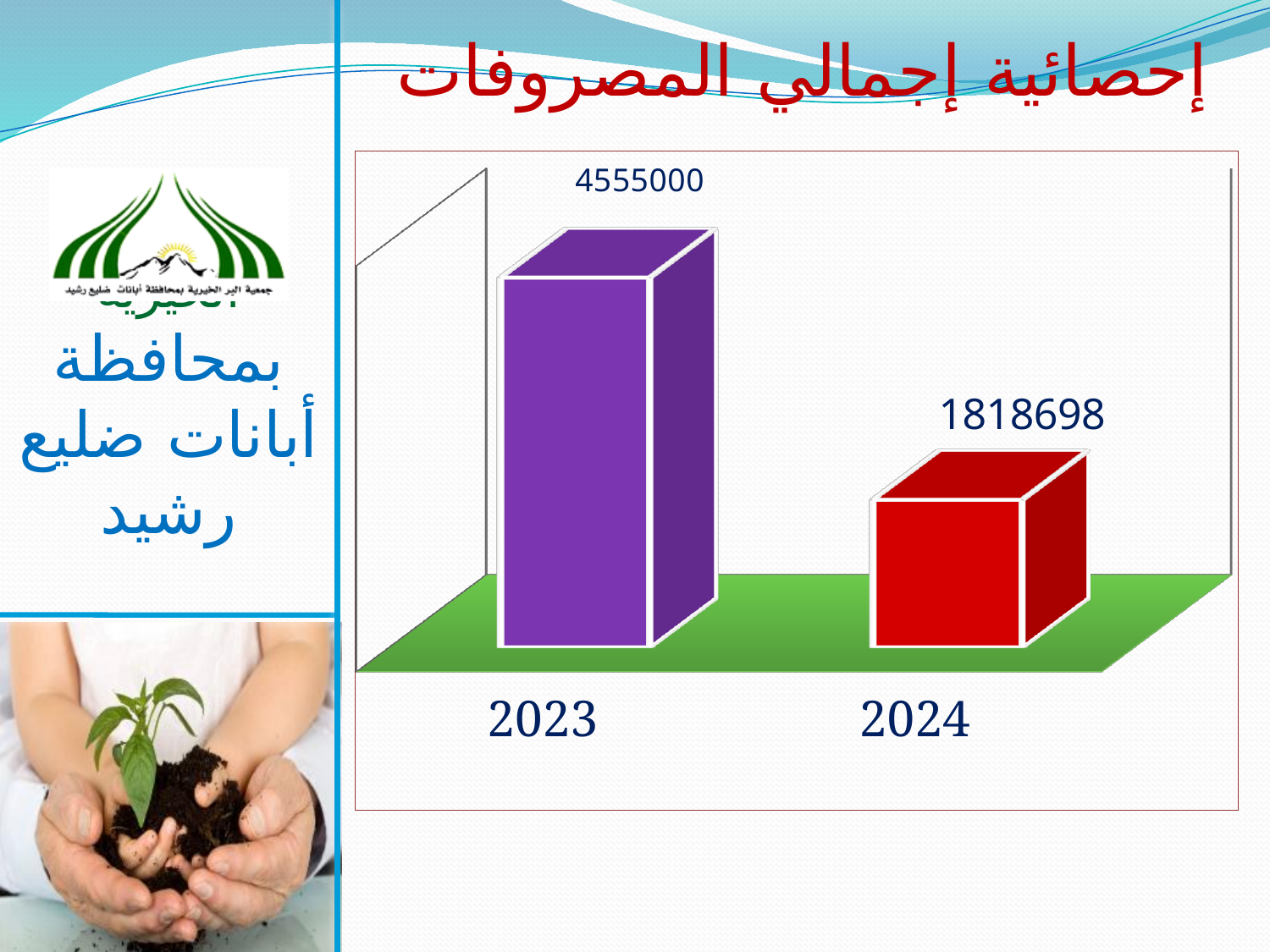
What is the value shown for 2024? 1818698 What colour is the bar for 2024? Red Do the values rise or fall from 2023 to 2024? Fall What kind of chart is shown on the slide? Bar chart Which year has the highest value? 2023 How many categories are shown on the chart? 2 What is the difference between the values for 2023 and 2024? 2736302 What is the value shown for 2023? 4555000 Which is larger, the value for 2023 or the value for 2024? 2023 Which year has the lowest value? 2024 What is the title of the chart on the slide? إحصائية إجمالي المصروفات